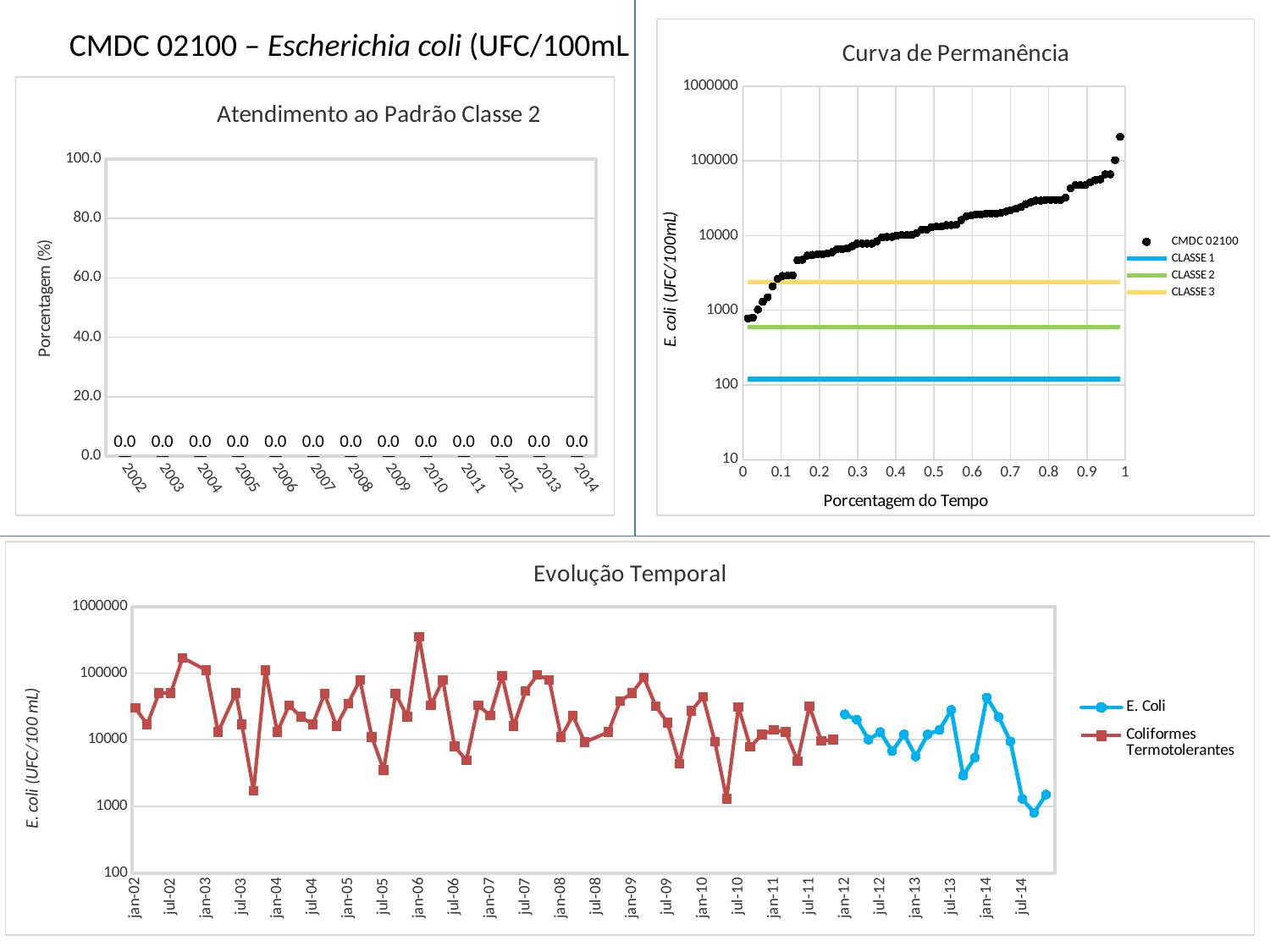
In the 'Curva de Permanência' chart, which line is higher, CLASSE 1 or CLASSE 3? CLASSE 3 What kind of chart is 'Atendimento ao Padrão Classe 2'? bar chart In the 'Atendimento ao Padrão Classe 2' chart, what is the value for 2005? 0.0 In the 'Curva de Permanência' chart, is the CLASSE 3 line greater or less than 1000? greater In the 'Curva de Permanência' chart, is the CLASSE 1 line greater or less than 1000? less What is the x-axis title of the 'Curva de Permanência' chart? Porcentagem do Tempo How many entries does the legend of the 'Curva de Permanência' chart list? 4 How many years are shown on the x axis of the 'Atendimento ao Padrão Classe 2' chart? 13 In the 'Evolução Temporal' chart, is the highest Coliformes Termotolerantes value greater or less than 100000? greater In the 'Curva de Permanência' chart, do the CMDC 02100 points rise or fall as Porcentagem do Tempo increases? rise In the 'Atendimento ao Padrão Classe 2' chart, what is the value for 2014? 0.0 How many series does the legend of the 'Evolução Temporal' chart list? 2